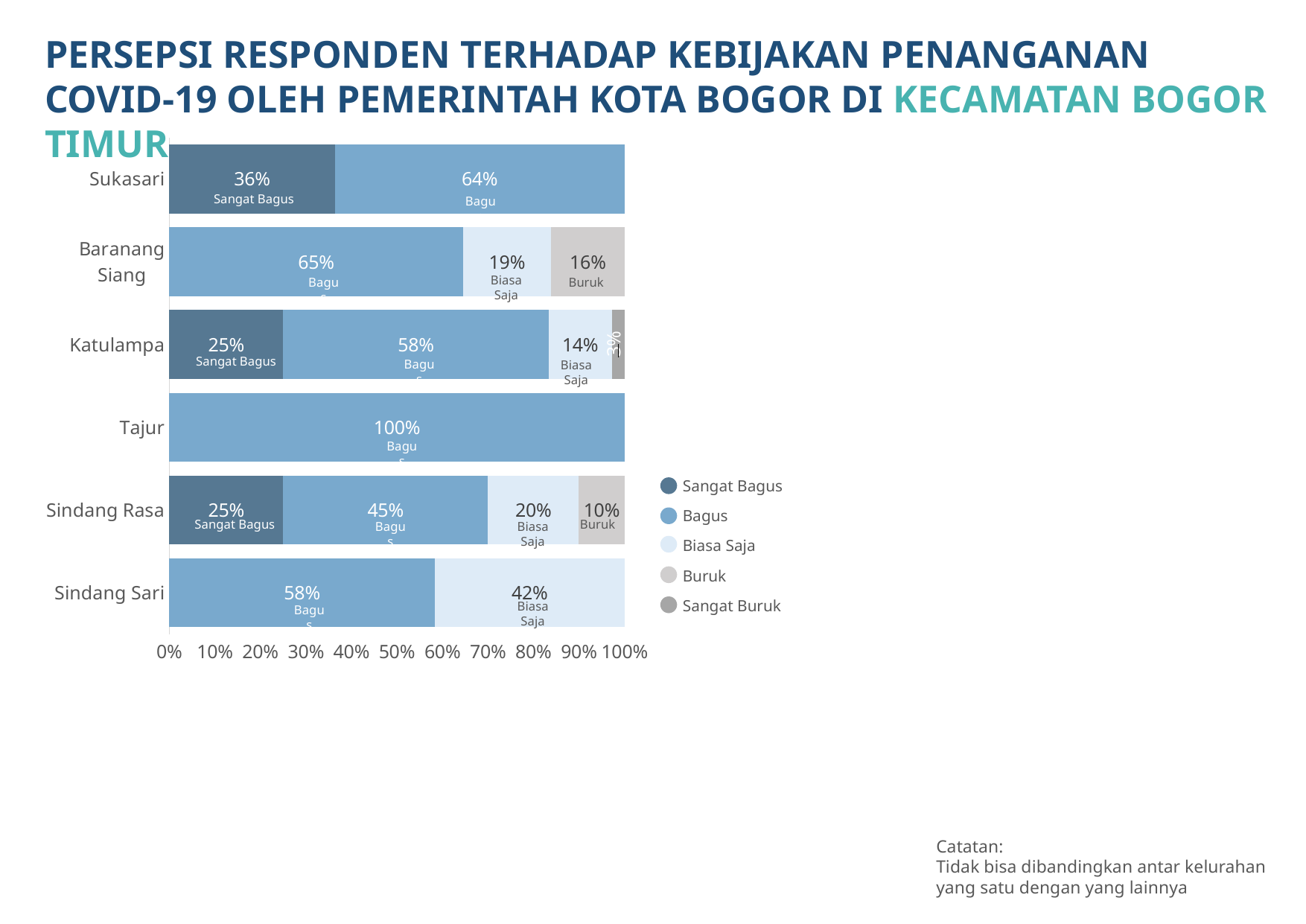
What percentage of respondents in Sindang Sari answered Biasa Saja? 42% What is the Buruk share for Sindang Rasa? 10% Which kelurahan has the lowest Bagus share? Sindang Rasa What is the Bagus share for Baranang Siang? 65% Which kelurahan has the highest Bagus share? Tajur How many kelurahan are shown on the chart? 6 What percentage of respondents in Sukasari rated the policy as Sangat Bagus? 36% What is the difference between the Bagus share and the Biasa Saja share in Sindang Sari? 16% What is the total of the Sukasari bar? 100% How many series does the legend list? 5 Which is larger: the Sangat Bagus share in Sukasari or the Sangat Bagus share in Katulampa? Sukasari What kind of chart is shown on the slide? Stacked bar chart